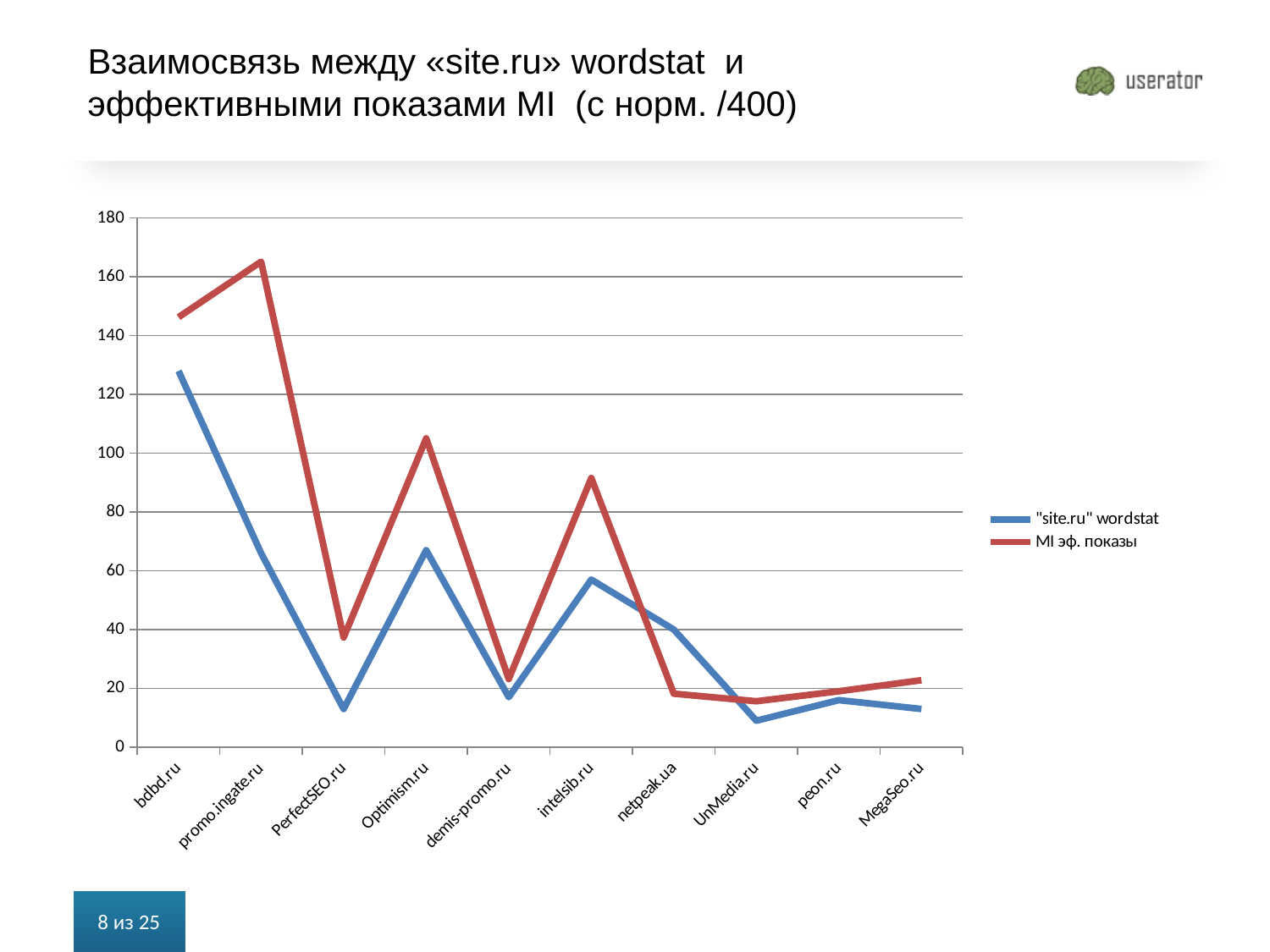
Is the "site.ru" wordstat value for bdbd.ru greater or less than 120? greater How many series does the legend list? 2 At Optimism.ru, which series has the larger value, "site.ru" wordstat or "MI эф. показы"? MI эф. показы Is the "MI эф. показы" value for Optimism.ru greater or less than 100? greater Which colour is used for the "MI эф. показы" series? red Is the "MI эф. показы" value for promo.ingate.ru greater or less than 160? greater For which category is the "MI эф. показы" series highest? promo.ingate.ru How many categories are shown on the x axis? 10 At netpeak.ua, which series has the larger value, "site.ru" wordstat or "MI эф. показы"? "site.ru" wordstat For which category is the "site.ru" wordstat series highest? bdbd.ru What kind of chart is shown on the slide? line chart